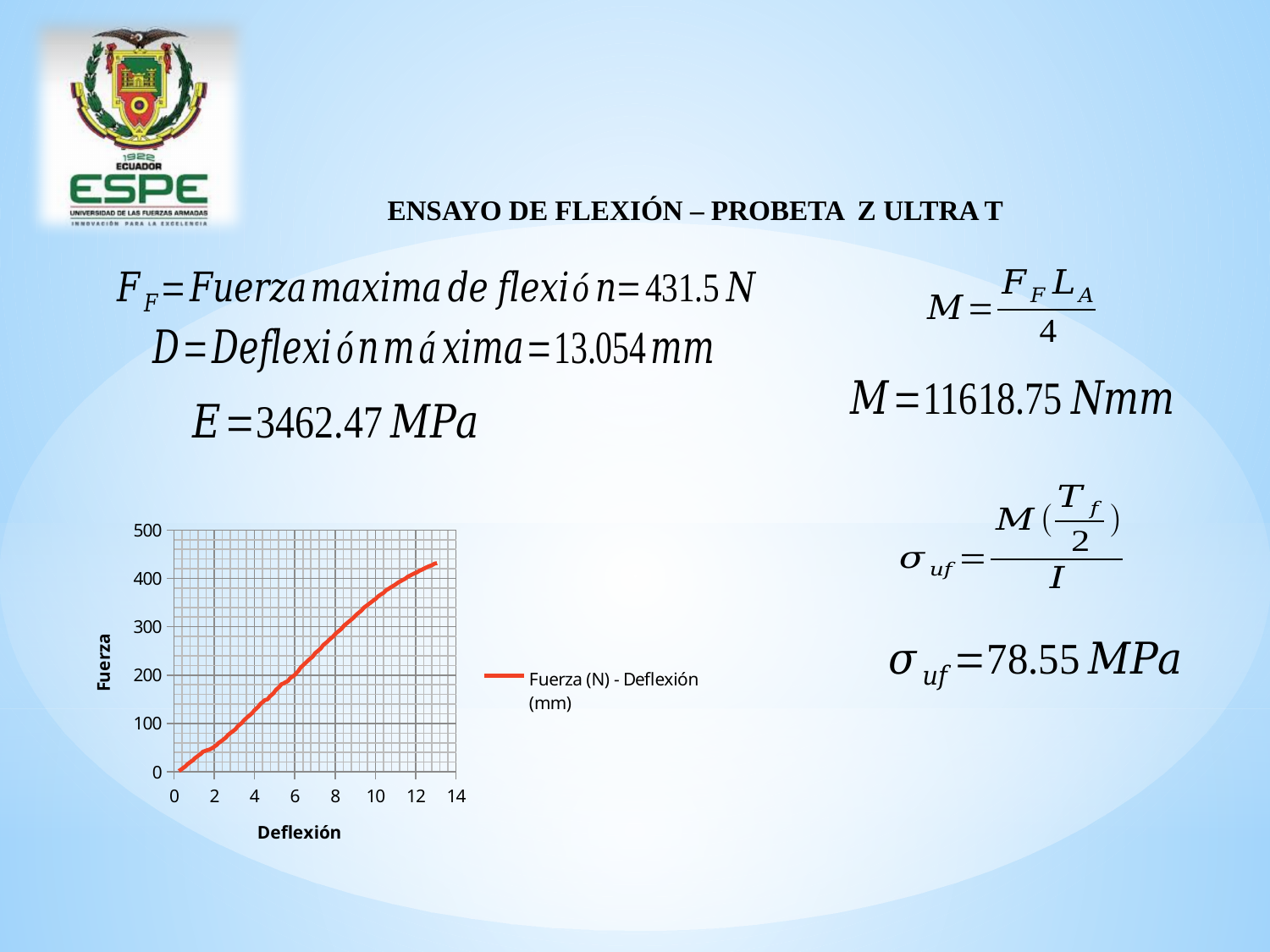
Is the highest Fuerza value reached by the curve greater or less than 500? less What kind of chart is shown on the slide? line chart What is the title of the vertical axis of the chart? Fuerza How many series does the chart legend list? 1 Is the value of Fuerza at a Deflexión of 2 greater or less than 100? less Is the value of Fuerza at a Deflexión of 10 greater or less than 400? less What is the legend entry for the series plotted in the chart? Fuerza (N) - Deflexión (mm) Is the Fuerza value at a Deflexión of 12 larger or smaller than the value at a Deflexión of 4? larger Does the plotted force rise or fall as deflexión increases along the x axis? rise